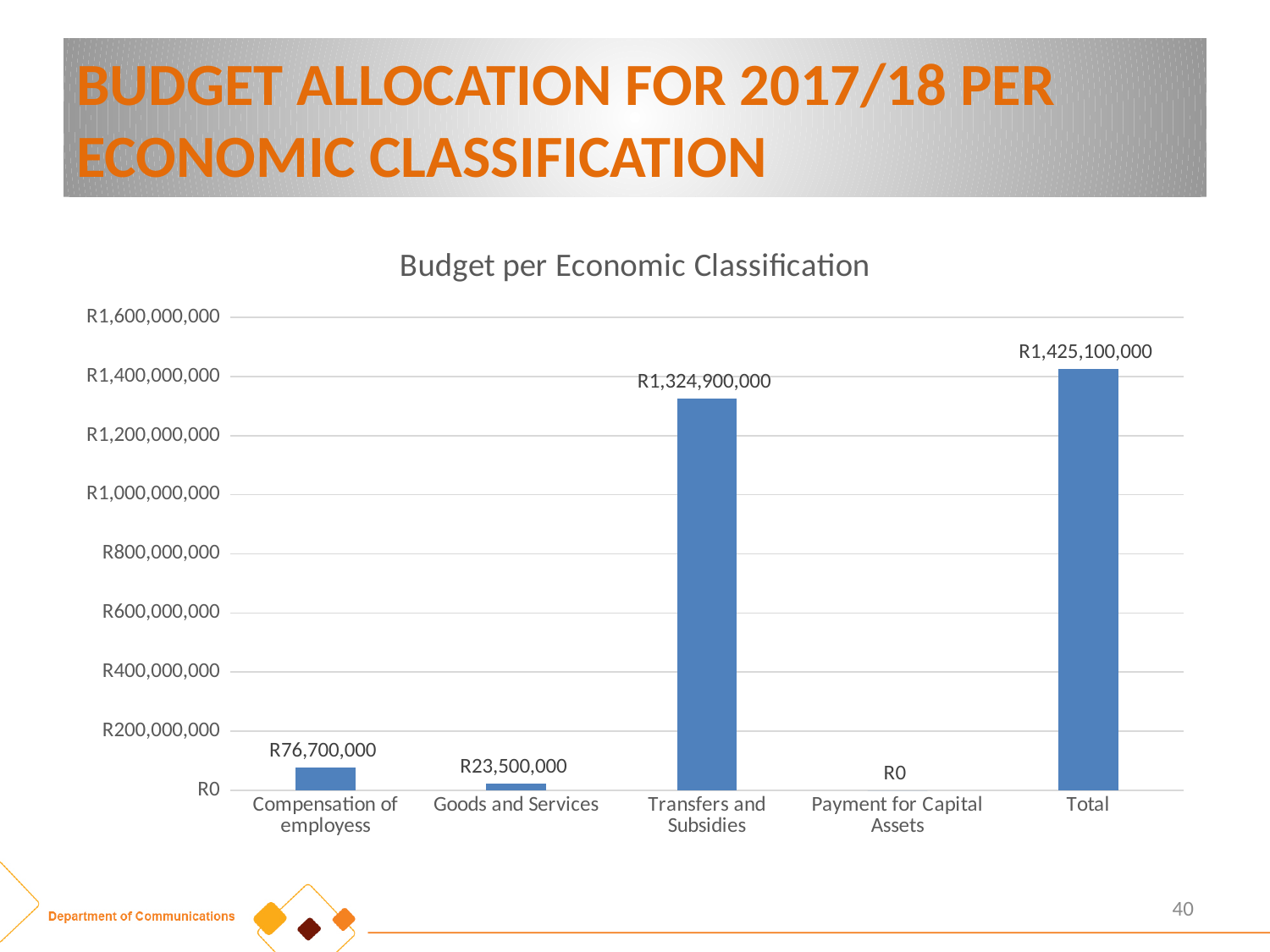
What type of chart is shown on the slide? Bar chart What is the difference between the budgets for Compensation of employess and Goods and Services? R53,200,000 What is the budget for Goods and Services? R23,500,000 What is the budget for Transfers and Subsidies? R1,324,900,000 What is the budget for Payment for Capital Assets? R0 Which category has the lowest budget? Payment for Capital Assets What is the budget for Compensation of employess? R76,700,000 Excluding the Total bar, which category has the highest budget? Transfers and Subsidies What is the value shown for the Total bar? R1,425,100,000 How many categories are shown on the x axis? 5 Is the value for Transfers and Subsidies greater or less than R1,200,000,000? greater Which is larger, the budget for Compensation of employess or for Goods and Services? Compensation of employess